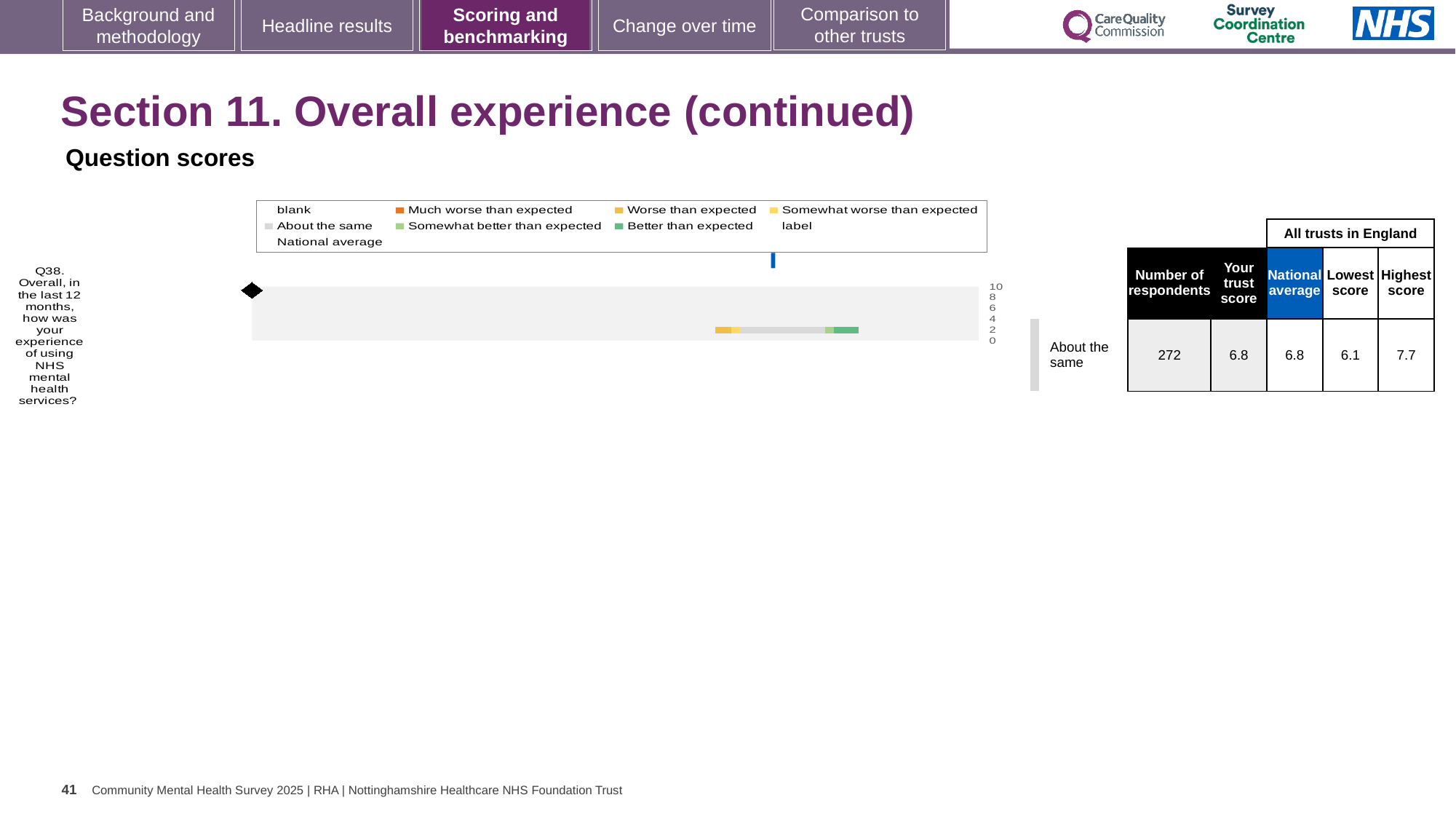
Which legend entry is shown in dark green in the chart? Better than expected Which question number is plotted in the chart? Q38 In the table beside the chart, what is the highest score among all trusts in England for Q38? 7.7 In the table beside the chart, what is the lowest score among all trusts in England for Q38? 6.1 What benchmark category is the trust's Q38 score labelled as next to the chart? About the same How many survey questions are plotted in the chart? 1 What kind of chart is used to show the Q38 question score? bar chart In the table beside the chart, what is the trust's score for Q38? 6.8 Which legend entry is shown in orange in the chart? Much worse than expected In the table beside the chart, what is the number of respondents for Q38? 272 In the table beside the chart, what is the difference between the highest and lowest scores for Q38? 1.6 In the table beside the chart, what is the national average for Q38? 6.8